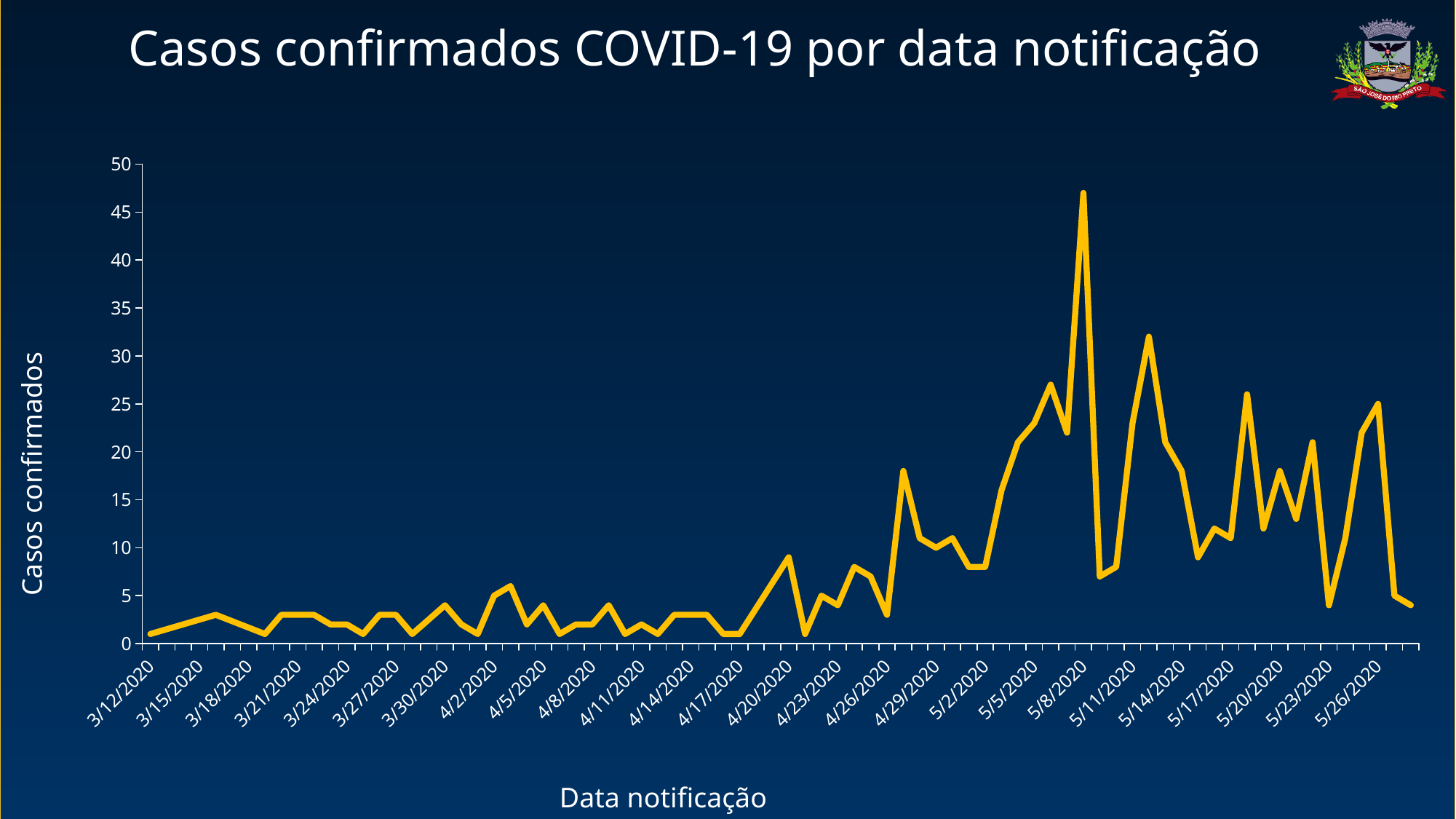
Is the value for 5/23/2020 greater or less than 10? less Is the value for 5/8/2020 greater or less than 40? greater Is the value for 5/26/2020 greater or less than 20? greater What is the title of the chart? Casos confirmados COVID-19 por data notificação Which date has the larger value, 5/8/2020 or 5/26/2020? 5/8/2020 What is the label of the vertical axis? Casos confirmados What kind of chart is shown on the slide? line chart On which date does the line reach its highest value? 5/8/2020 Do the values generally rise or fall between 4/17/2020 and 5/8/2020? rise